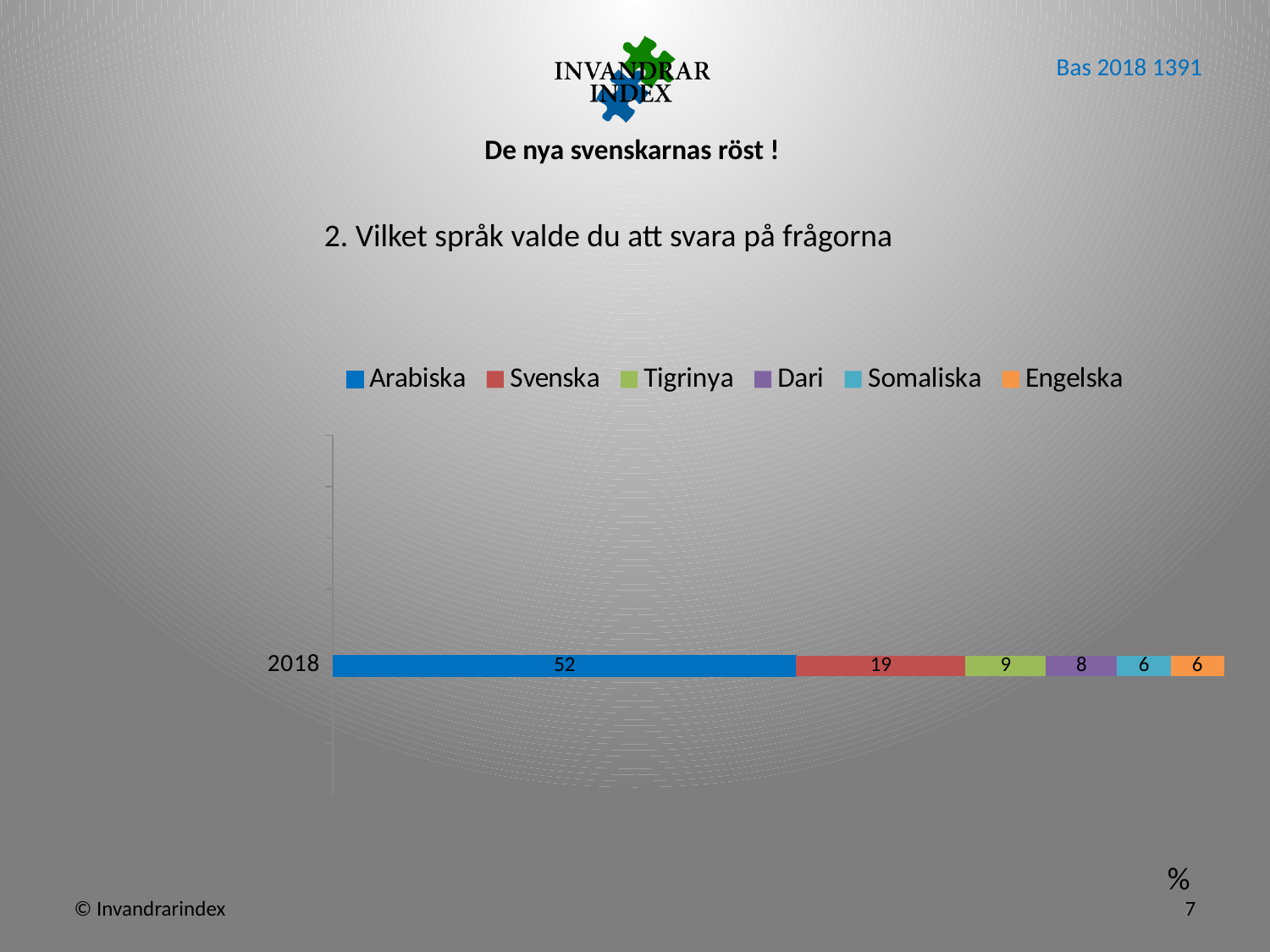
What is the difference between the Arabiska and Svenska values in the 2018 bar? 33 Which language series has the highest value in the 2018 bar? Arabiska What value is shown for Dari in the 2018 bar? 8 What value is shown for Arabiska in the 2018 bar? 52 What value is shown for Svenska in the 2018 bar? 19 Which is larger in the 2018 bar, Tigrinya or Dari? Tigrinya Which legend entry is shown in orange? Engelska What kind of chart is shown on the slide? Stacked bar chart What is the total of the stacked 2018 bar? 100 How many category bars are plotted in the chart? 1 What value is shown for Tigrinya in the 2018 bar? 9 How many series does the legend list? 6